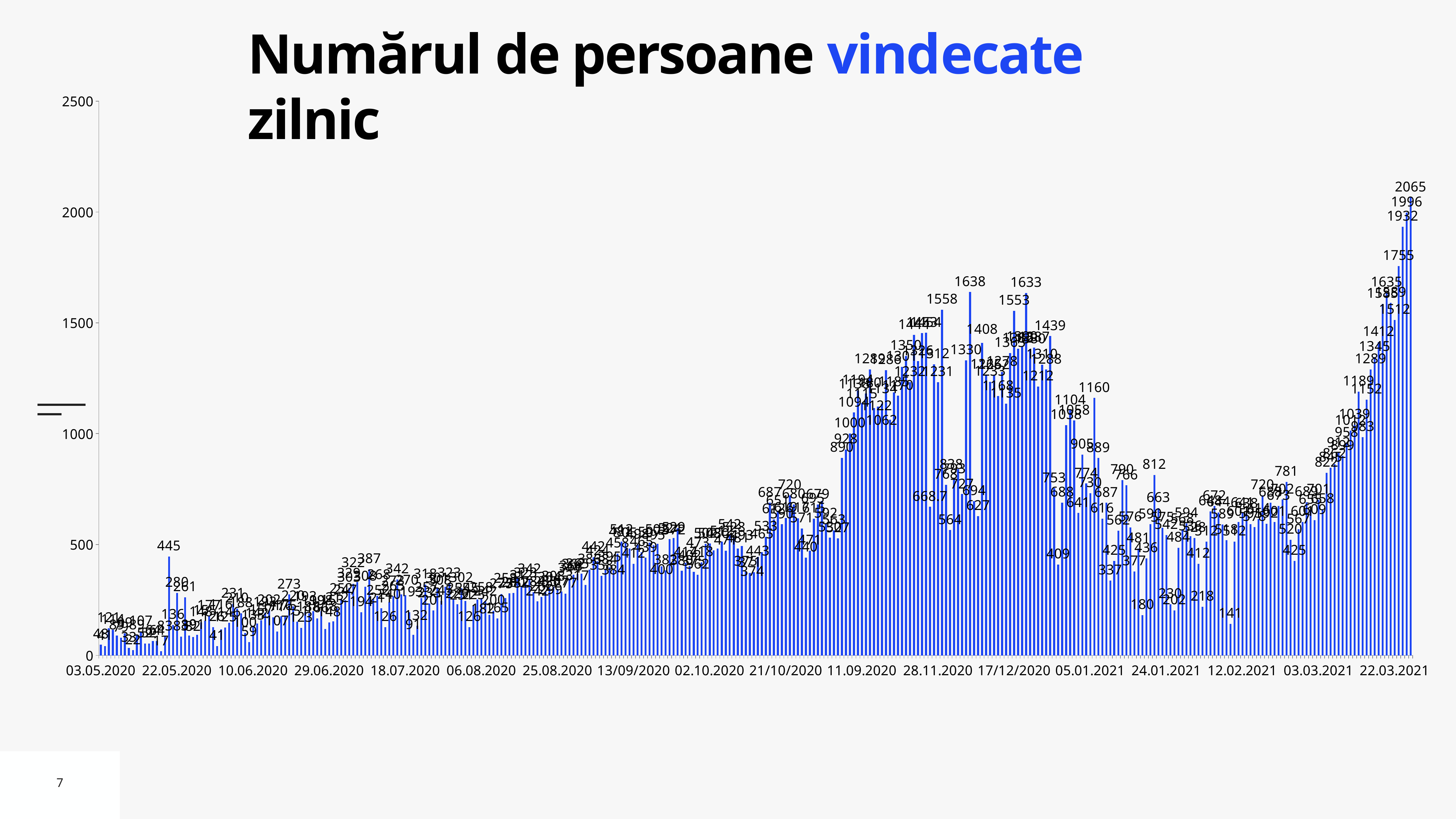
Is the highest value on the chart greater or less than 2000? greater What is the difference between the two highest labelled values, 2065 and 1996? 69 What kind of chart is shown on the slide? bar chart Are the values for the first days shown (around 03.05.2020) greater or less than 500? less Which is larger: the peak value labelled 445 in May 2020 or the peak value labelled 1638 in late 2020? 1638 Overall, do the values rise or fall from 03.05.2020 to 22.03.2021? rise What is the first date shown on the x axis? 03.05.2020 What is the highest value labelled near the 17/12/2020 tick? 1633 What is the highest value labelled on the chart? 2065 What is the difference between the labelled peaks 1638 and 1633? 5 Is the value labelled 812 (late January 2021) greater or less than 1000? less What is the title of the chart? Numărul de persoane vindecate zilnic